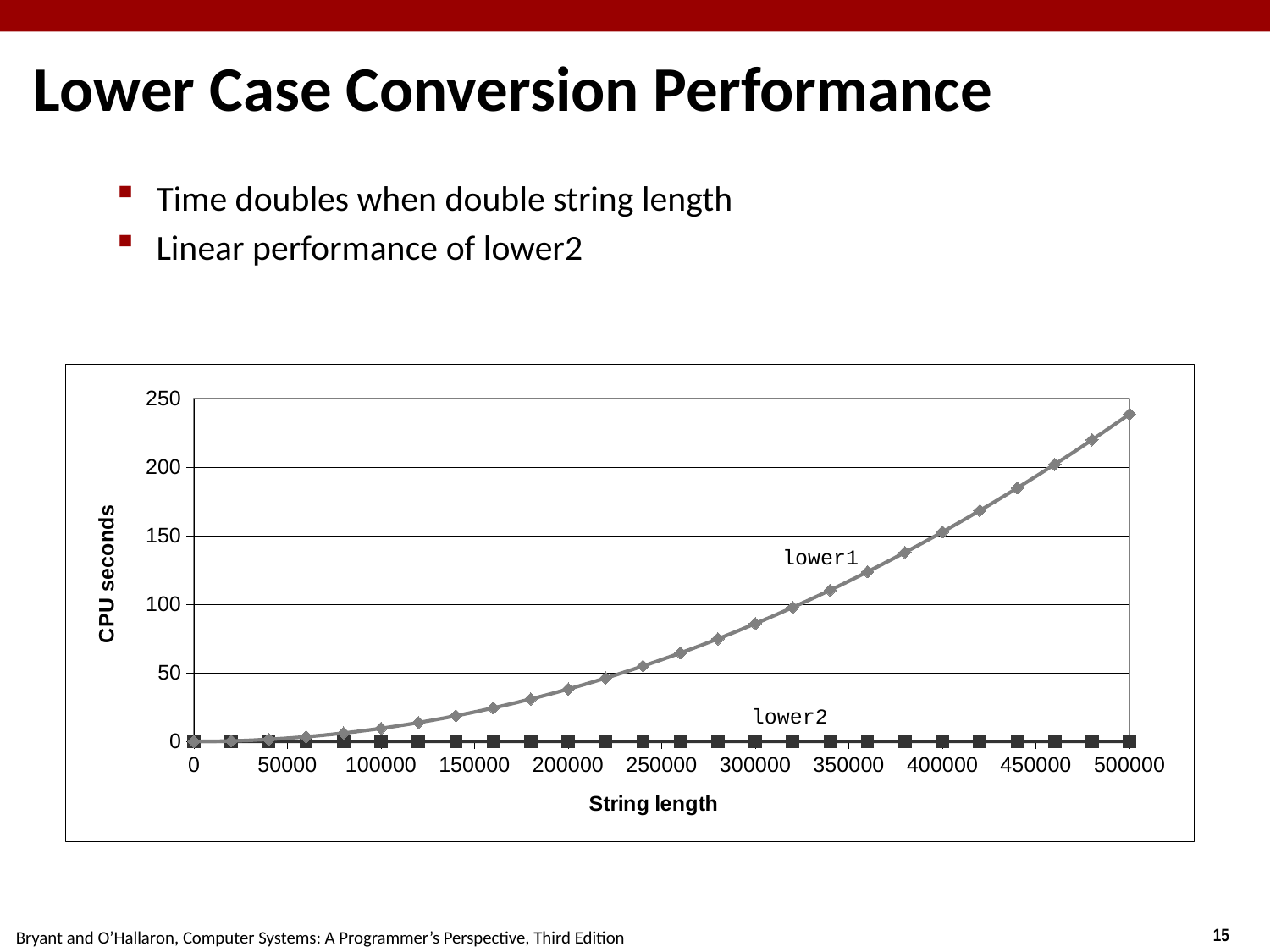
Is the value for lower1 at a string length of 400000 greater or less than 100? greater Is the value for lower2 at a string length of 500000 greater or less than 50? less What is the label of the y axis? CPU seconds Is the value for lower1 at a string length of 300000 greater or less than 100? less What is the maximum value shown on the y axis? 250 Which series has the higher CPU seconds at a string length of 500000? lower1 Does the CPU seconds for lower1 rise or fall as string length increases? rise What are the names of the two series plotted on the chart? lower1 and lower2 What kind of chart is shown on the slide? line chart How many data series are plotted on the chart? 2 Which series reaches the highest CPU seconds on the chart? lower1